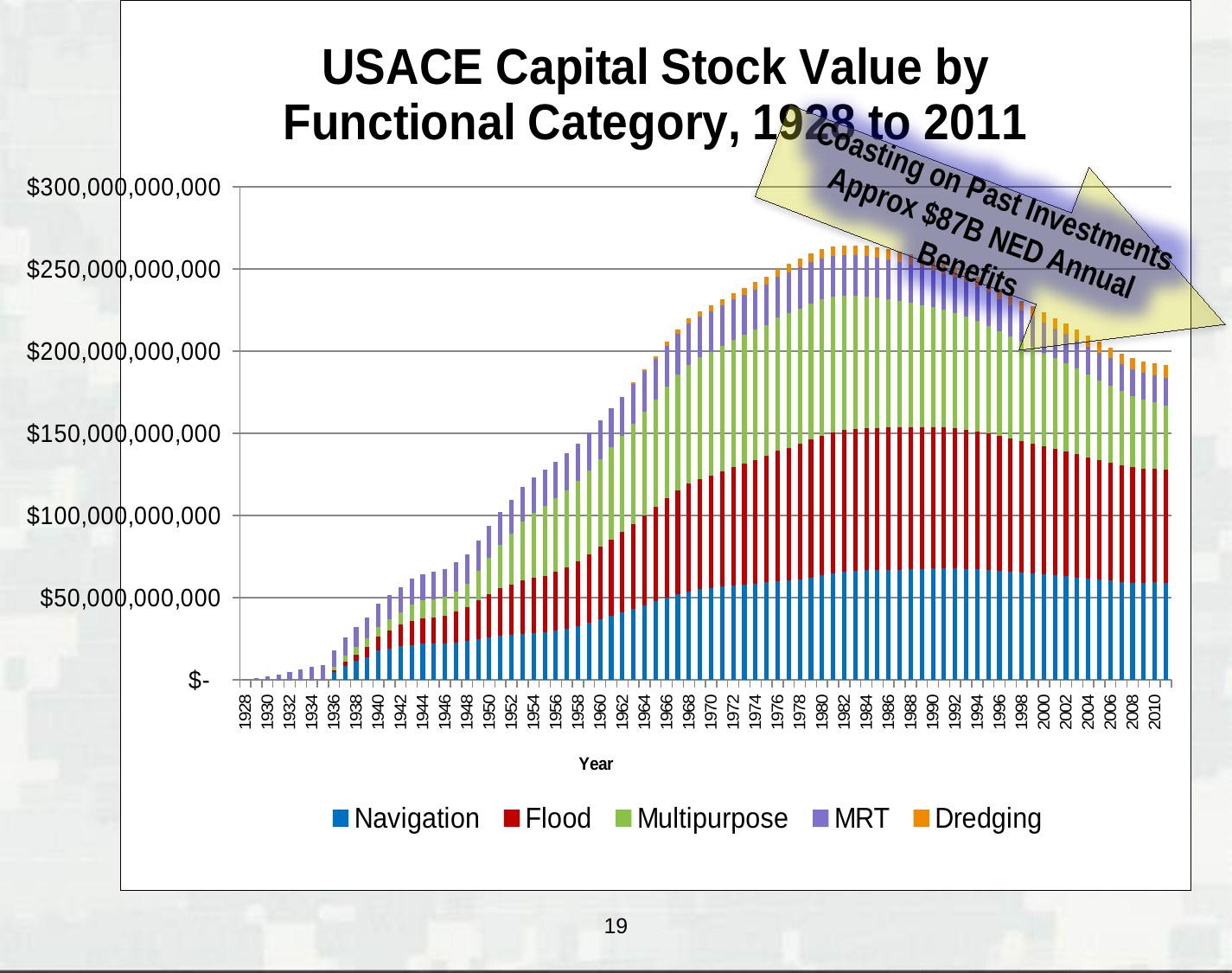
What is the title of the chart? USACE Capital Stock Value by Functional Category, 1928 to 2011 Is the total capital stock value for 1970 greater or less than $200,000,000,000? greater Is the total capital stock value for 1948 greater or less than $100,000,000,000? less Which series is shown at the bottom of each stacked bar? Navigation Is the total capital stock value for 1980 greater or less than $250,000,000,000? greater How many series does the legend list? 5 Do the total stacked values rise or fall from 1928 to 1980? rise Do the total stacked values rise or fall from 1990 to 2011? fall What kind of chart is shown on the slide? Stacked bar chart